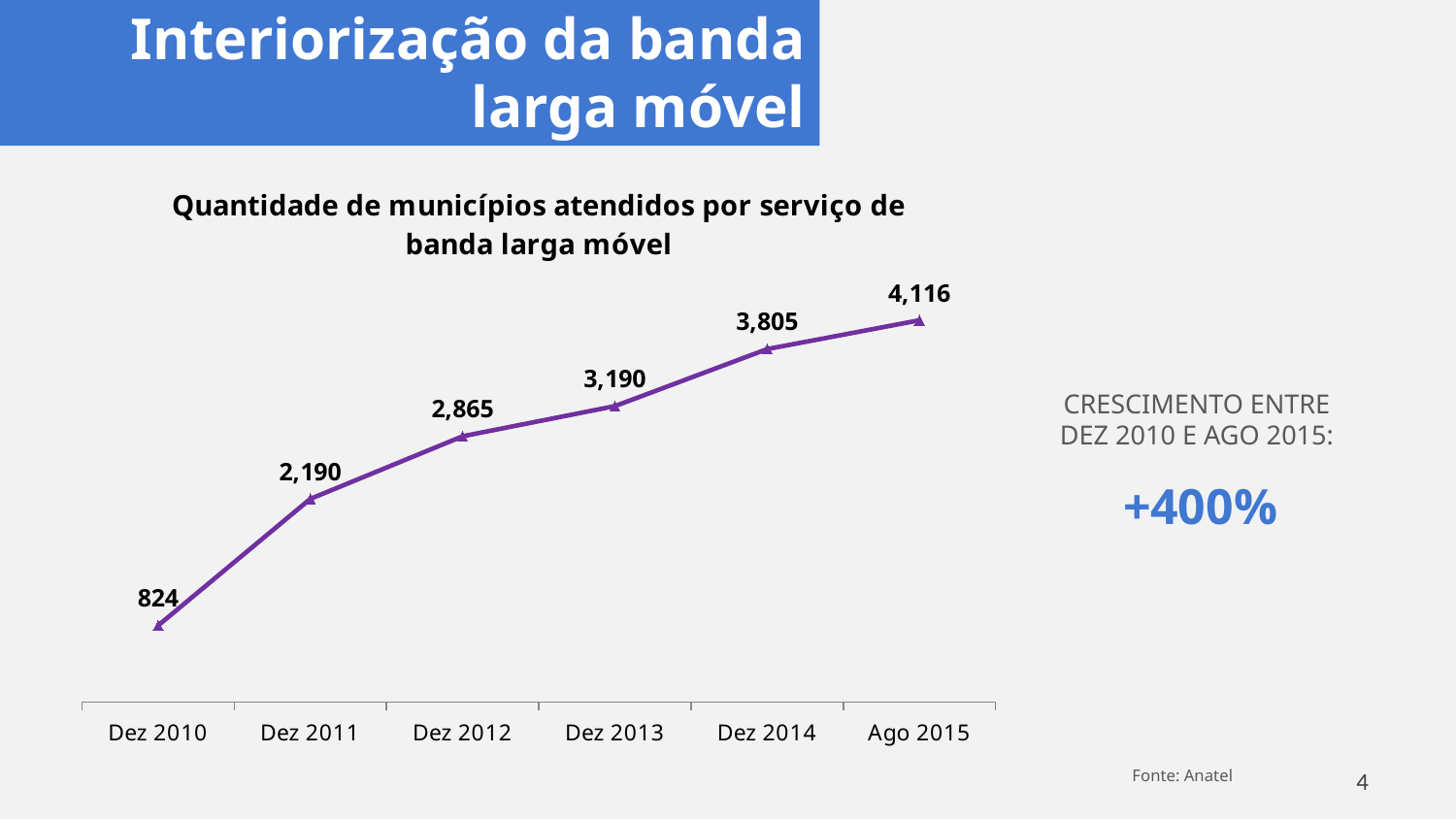
What kind of chart is shown? line chart Which point has the highest value? Ago 2015 What is the title of the chart? Quantidade de municípios atendidos por serviço de banda larga móvel Which is larger, the value for Dez 2011 or the value for Dez 2013? Dez 2013 How many data points are plotted on the chart? 6 What is the difference between the values for Ago 2015 and Dez 2010? 3,292 What is the difference between the values for Dez 2014 and Dez 2013? 615 What is the value for Dez 2010? 824 Do the values rise or fall from Dez 2010 to Ago 2015? rise Which point has the lowest value? Dez 2010 What is the value for Ago 2015? 4,116 What is the value for Dez 2012? 2,865